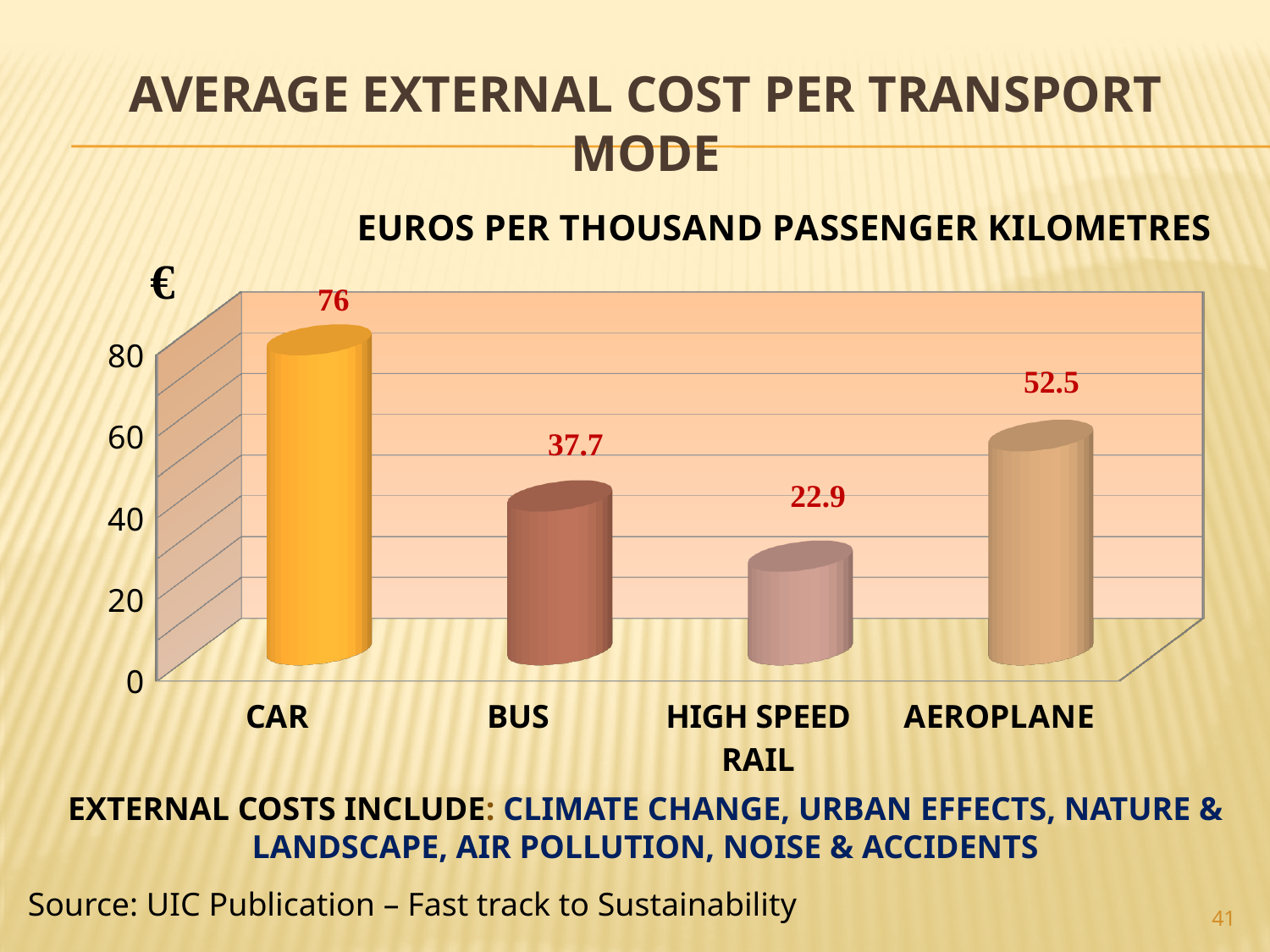
What kind of chart is shown on the slide? Bar chart What is the average external cost for HIGH SPEED RAIL? 22.9 How many transport modes are shown in the chart? 4 What is the average external cost for CAR? 76 What is the average external cost for AEROPLANE? 52.5 Which transport mode has the highest average external cost? CAR What is the difference between the external cost of BUS and HIGH SPEED RAIL? 14.8 What is the average external cost for BUS? 37.7 Which has a higher average external cost, BUS or AEROPLANE? AEROPLANE What unit is the chart measured in, according to the subtitle? Euros per thousand passenger kilometres Which transport mode has the lowest average external cost? HIGH SPEED RAIL What is the difference between the external cost of CAR and AEROPLANE? 23.5